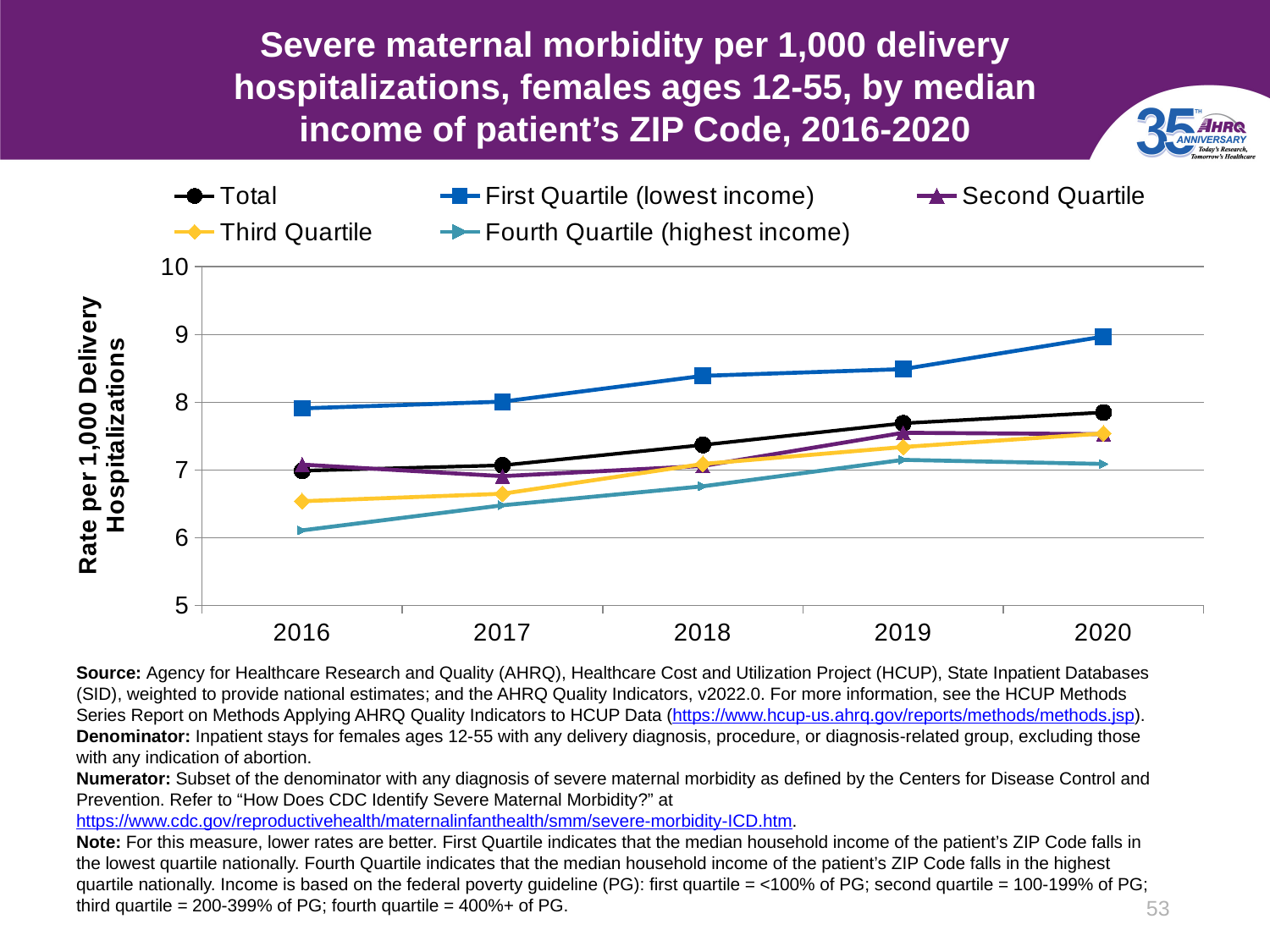
What is the label on the y axis? Rate per 1,000 Delivery Hospitalizations Is the value for Fourth Quartile (highest income) in 2016 greater or less than 7? less In 2019, which is larger: the rate for First Quartile (lowest income) or Fourth Quartile (highest income)? First Quartile (lowest income) What kind of chart is shown on the slide? Line chart How many years are shown along the x axis? 5 Does the First Quartile (lowest income) rate rise or fall from 2016 to 2020? Rise Which series has the highest rate in 2020? First Quartile (lowest income) Is the value for Total in 2020 greater or less than 8? less Which legend entry is marked as the highest income group? Fourth Quartile (highest income) Which series has the lowest rate in 2016? Fourth Quartile (highest income) Is the value for First Quartile (lowest income) in 2018 greater or less than 8? greater How many series does the legend list? 5